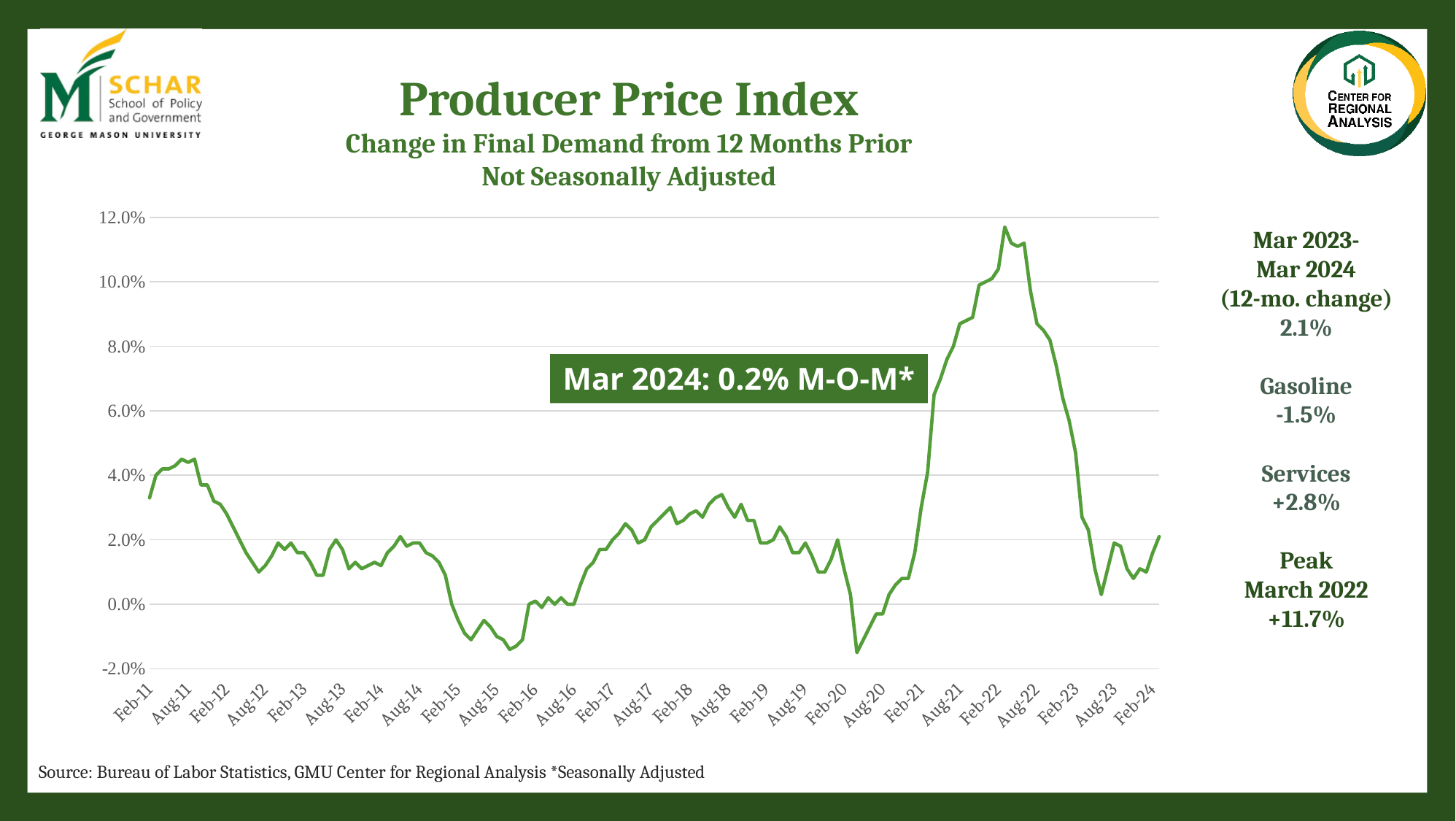
According to the slide, in which month did the Producer Price Index 12-month change peak? March 2022 What is the month-over-month change for Mar 2024 shown in the chart annotation? 0.2% What is the title of the chart on the slide? Producer Price Index How many data series are plotted in the chart? 1 Is the value for Aug-11 greater or less than 4.0%? greater Is the value for Feb-22 greater or less than 10.0%? greater Is the value for Aug-15 greater or less than 0.0%? less Which is larger, the value for Feb-22 or the value for Feb-11? Feb-22 What was the peak value of the 12-month change in the Producer Price Index, as stated on the slide? +11.7% Does the line rise or fall between Feb-22 and Feb-23? fall What is the 12-month change in the Producer Price Index from Mar 2023 to Mar 2024, as stated on the slide? 2.1% What kind of chart is shown on the slide? line chart